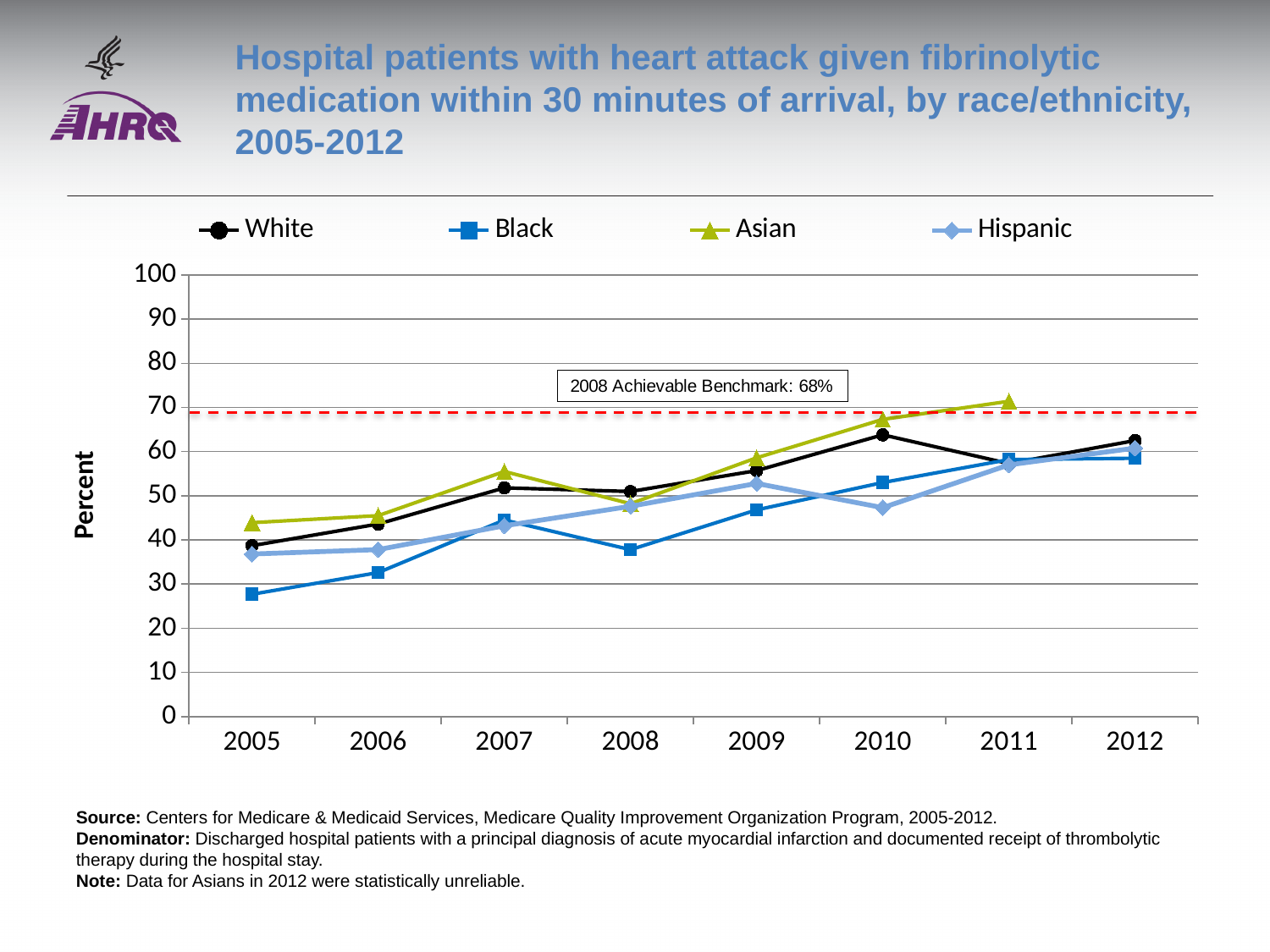
Which series is shown with a dashed red line? 2008 Achievable Benchmark Is the value for White in 2010 greater or less than 60? greater In 2008, which was larger, the value for White or the value for Black? White How many years are shown on the x axis? 8 Does the value for Black generally rise or fall from 2005 to 2012? rise What is the 2008 Achievable Benchmark value shown on the chart? 68% Is the value for Asian in 2010 greater or less than 60? greater Is the value for Black in 2005 greater or less than 30? less Which group had the highest value in 2011? Asian How many series does the legend list? 4 Which group had the lowest value in 2005? Black What kind of chart is shown on the slide? line chart